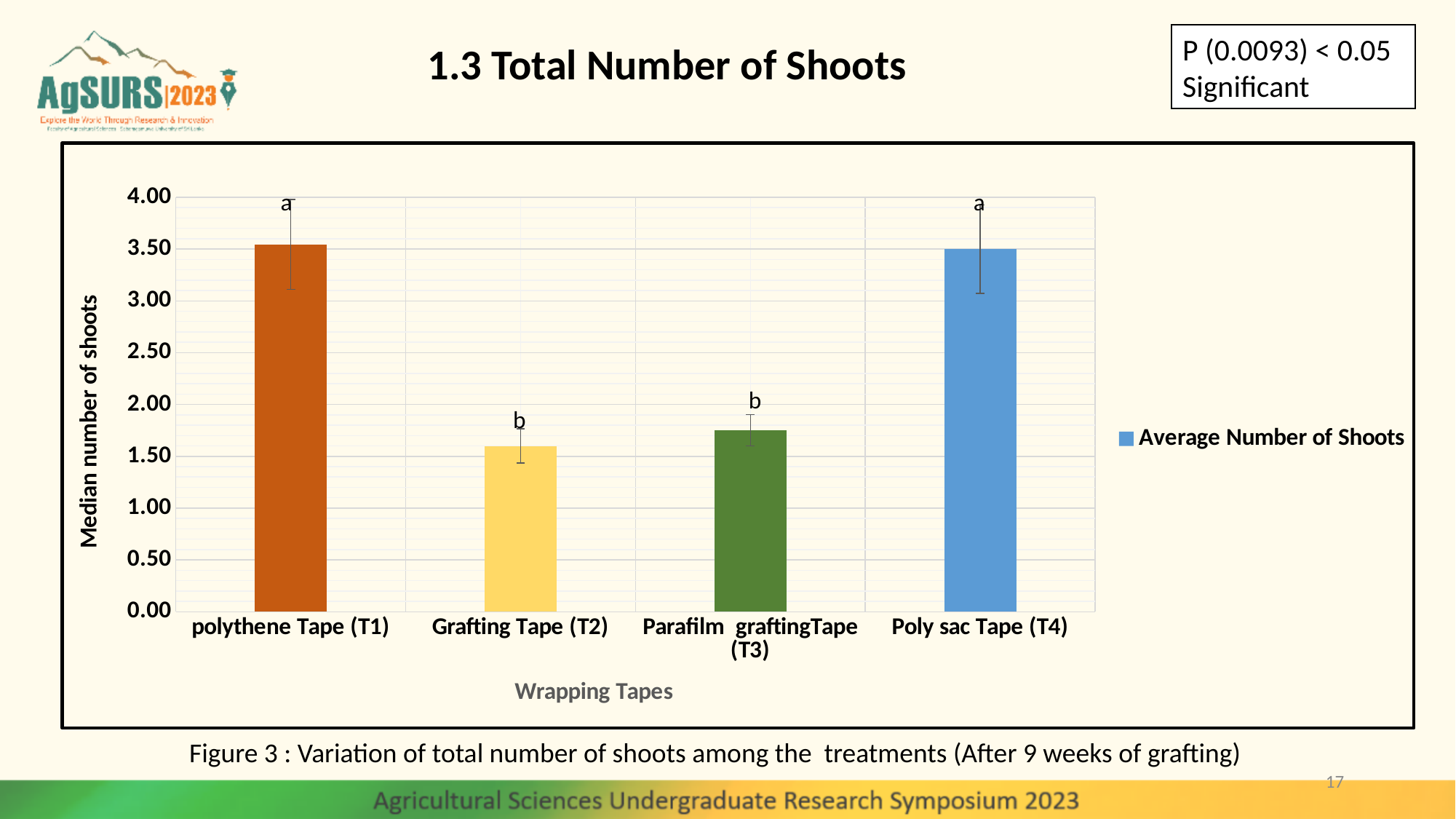
Is the value for Grafting Tape (T2) greater or less than 2.00? less Which has the larger value, Poly sac Tape (T4) or Parafilm graftingTape (T3)? Poly sac Tape (T4) What kind of chart is shown on the slide? bar chart Is the value for Parafilm graftingTape (T3) greater or less than 1.50? greater What is the series name shown in the legend? Average Number of Shoots Is the value for polythene Tape (T1) greater or less than 3.00? greater How many wrapping tape treatments are plotted on the x axis? 4 What is the title of the x axis? Wrapping Tapes Which has the larger value, polythene Tape (T1) or Grafting Tape (T2)? polythene Tape (T1) How many series does the legend list? 1